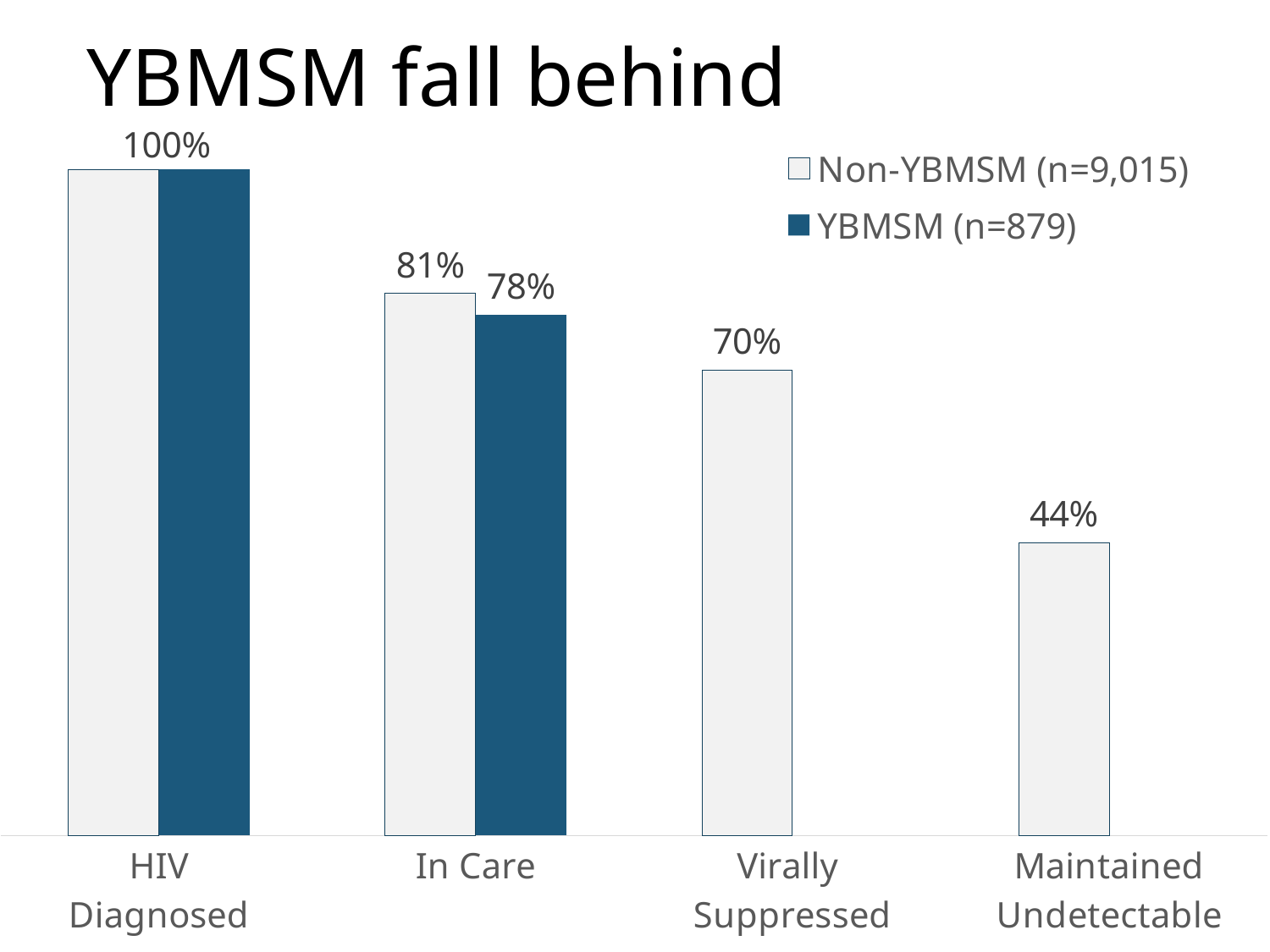
What is the YBMSM value for In Care? 78% What is the difference between the Non-YBMSM and YBMSM values for In Care? 3 percentage points What is the Non-YBMSM value for Virally Suppressed? 70% What value is labelled for the HIV Diagnosed category? 100% How many categories are shown on the x axis? 4 What is the Non-YBMSM value for In Care? 81% For In Care, which series has the larger value, Non-YBMSM or YBMSM? Non-YBMSM What kind of chart is shown on the slide? Bar chart Which category has the lowest Non-YBMSM value? Maintained Undetectable Do the Non-YBMSM values rise or fall from left to right across the categories? Fall What is the Non-YBMSM value for Maintained Undetectable? 44% How many series does the legend list? 2